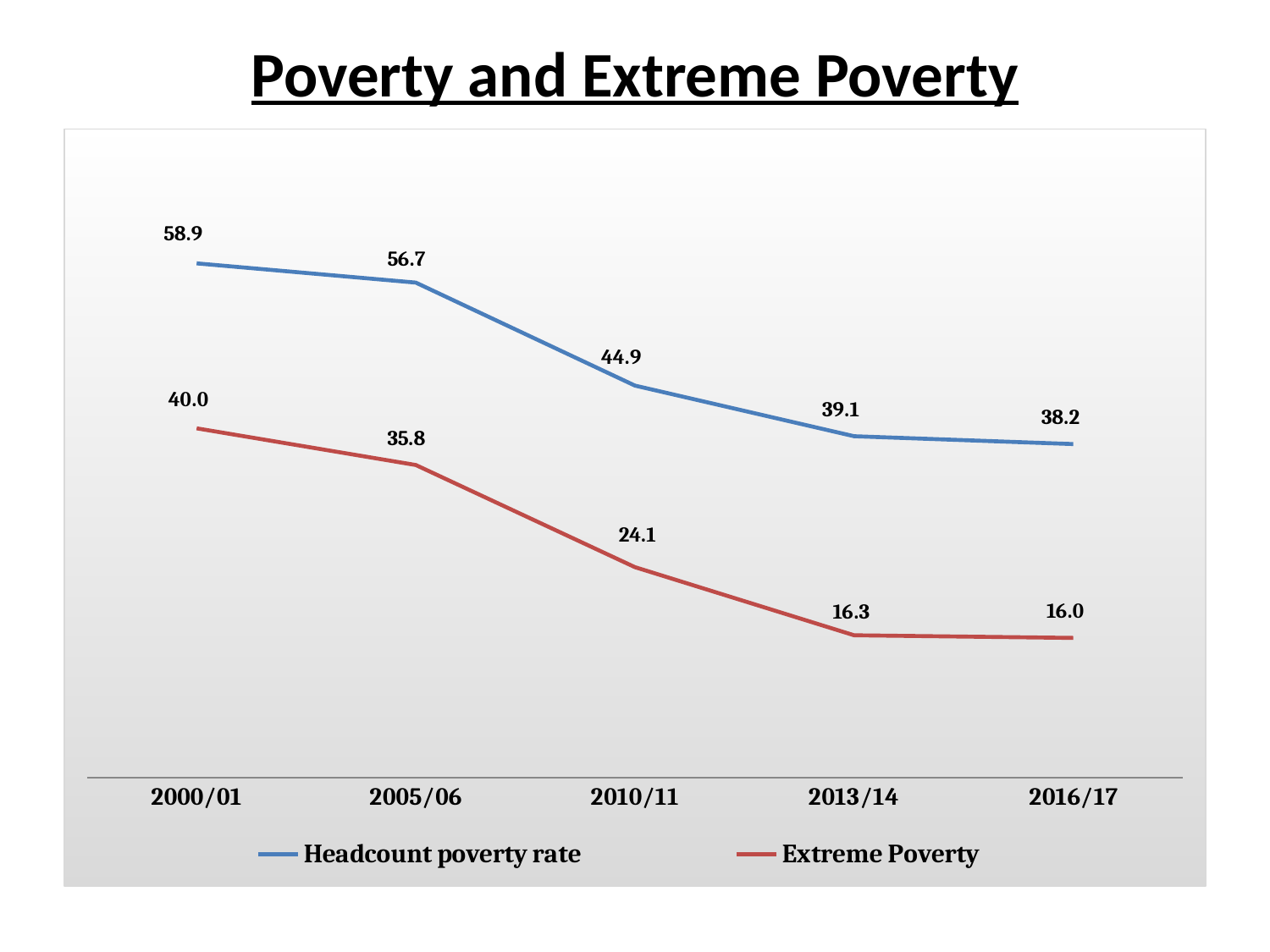
What kind of chart is shown on the slide? Line chart How many time periods are shown on the x axis? 5 What is the Headcount poverty rate in 2016/17? 38.2 What is the Headcount poverty rate in 2000/01? 58.9 What is the difference between the Headcount poverty rate and Extreme Poverty in 2013/14? 22.8 In which period is the Headcount poverty rate highest? 2000/01 How many series does the legend list? 2 By how much did the Headcount poverty rate fall from 2005/06 to 2010/11? 11.8 Do the Extreme Poverty values rise or fall from 2000/01 to 2016/17? Fall Which is larger: Extreme Poverty in 2005/06 or Extreme Poverty in 2013/14? 2005/06 What is the Extreme Poverty value in 2010/11? 24.1 In which period is the Extreme Poverty value lowest? 2016/17